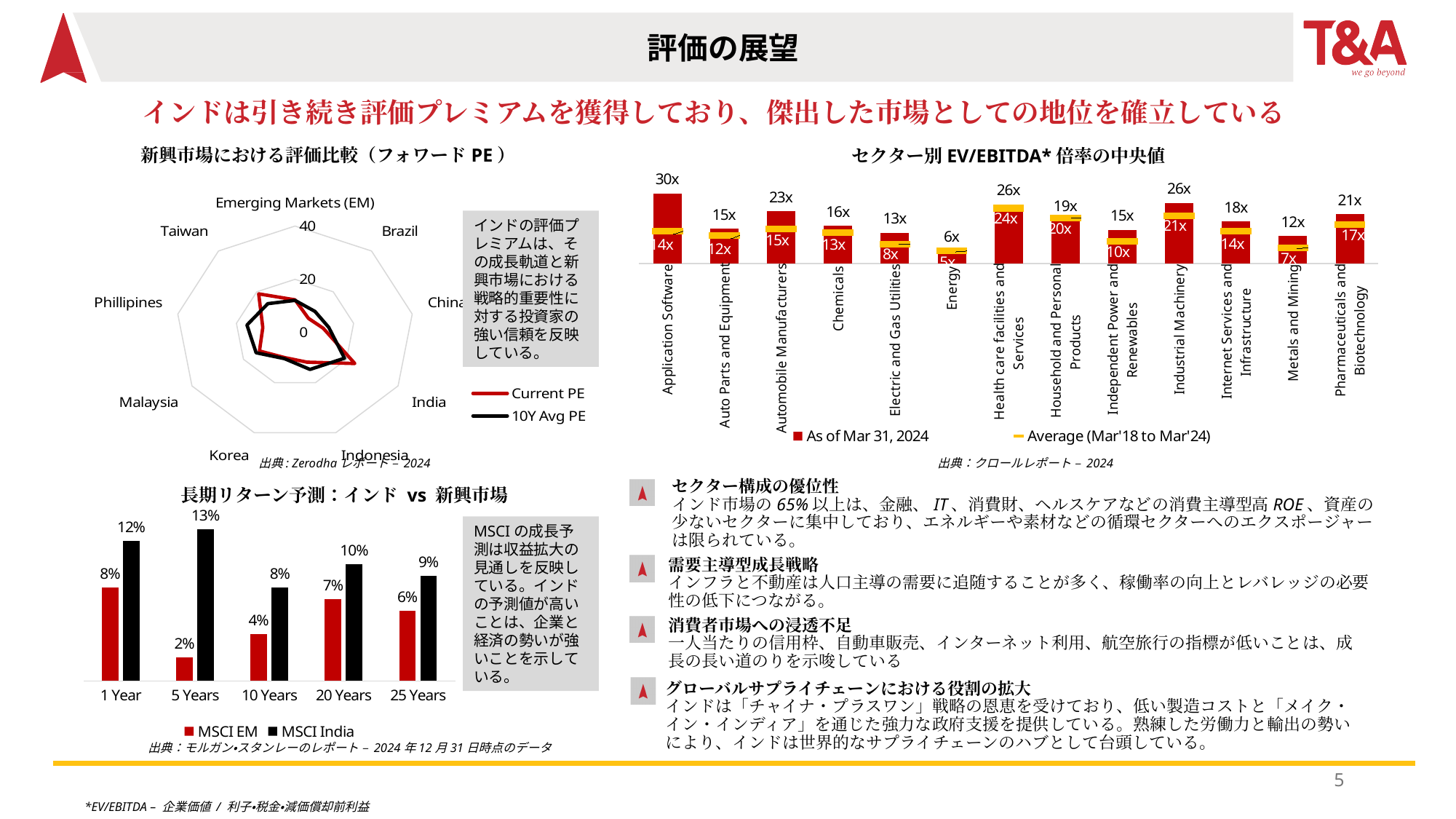
In the chart titled 'セクター別 EV/EBITDA* 倍率の中央値', what is the 'As of Mar 31, 2024' value for Application Software? 30x In the chart titled '長期リターン予測：インド vs 新興市場', which period has the lowest MSCI EM value? 5 Years In the chart titled 'セクター別 EV/EBITDA* 倍率の中央値', what is the 'Average (Mar'18 to Mar'24)' value for Health care facilities and Services? 24x In the chart titled '新興市場における評価比較（フォワード PE）', how many markets are shown around the radar? 9 In the chart titled 'セクター別 EV/EBITDA* 倍率の中央値', how many sectors are shown on the x axis? 13 In the chart titled 'セクター別 EV/EBITDA* 倍率の中央値', which is larger for Household and Personal Products: the 'As of Mar 31, 2024' value or the 'Average (Mar'18 to Mar'24)' value? Average (Mar'18 to Mar'24) In the chart titled 'セクター別 EV/EBITDA* 倍率の中央値', what is the difference between the 'As of Mar 31, 2024' value and the 'Average (Mar'18 to Mar'24)' value for Metals and Mining? 5x In the chart titled 'セクター別 EV/EBITDA* 倍率の中央値', which sector has the lowest 'As of Mar 31, 2024' value? Energy In the chart titled '長期リターン予測：インド vs 新興市場', what is the MSCI India value for 5 Years? 13% In the chart titled '長期リターン予測：インド vs 新興市場', what is the difference between MSCI India and MSCI EM for 10 Years? 4% In the chart titled '新興市場における評価比較（フォワード PE）', how many series does the legend list? 2 What kind of chart is the chart titled '長期リターン予測：インド vs 新興市場'? Bar chart